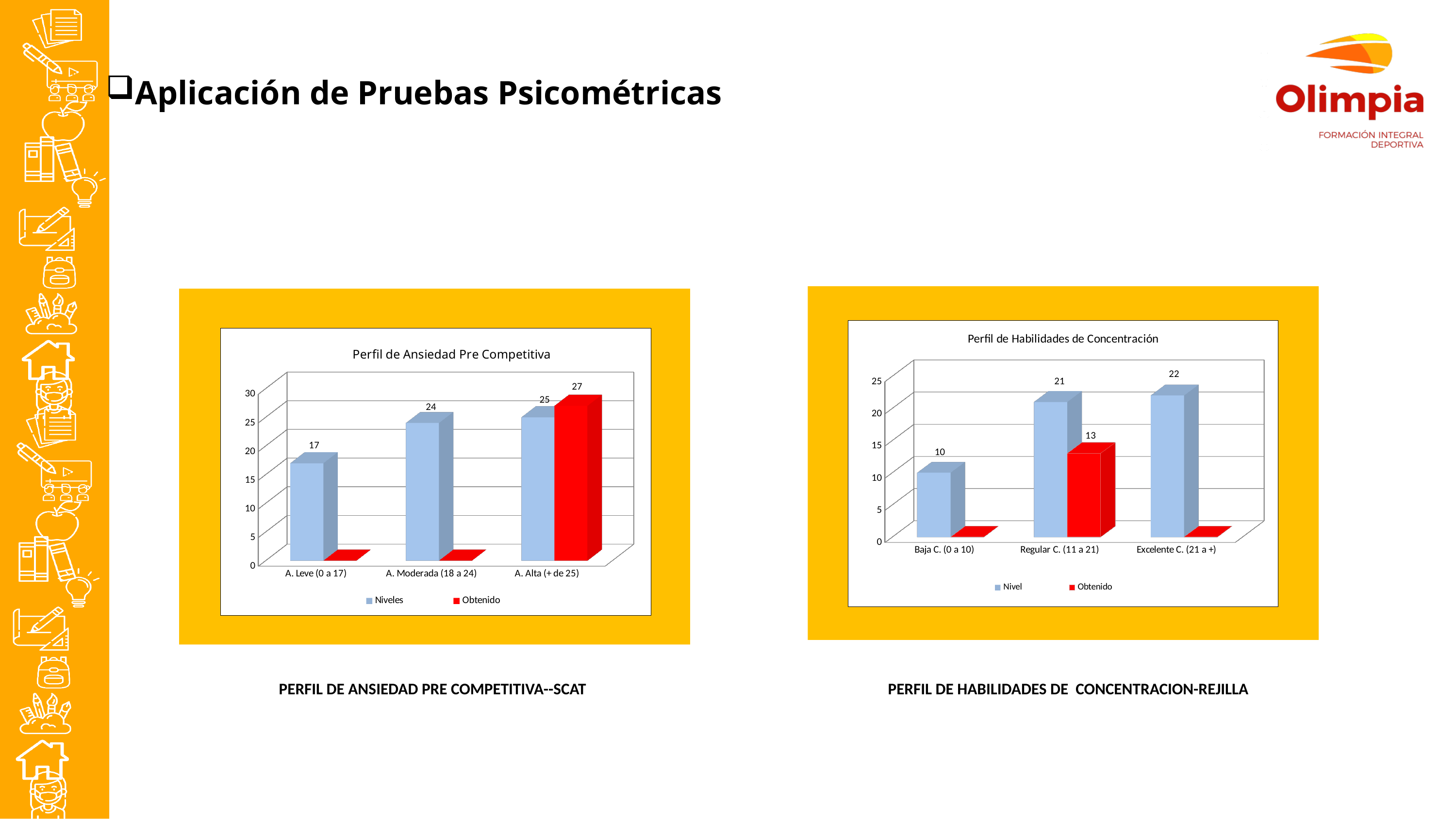
In the 'Perfil de Ansiedad Pre Competitiva' chart, what is the Obtenido value for A. Alta (+ de 25)? 27 What type of chart is the 'Perfil de Habilidades de Concentración' chart? bar chart In the 'Perfil de Ansiedad Pre Competitiva' chart, how many series does the legend list? 2 In the 'Perfil de Habilidades de Concentración' chart, what is the Obtenido value for Regular C. (11 a 21)? 13 In the 'Perfil de Ansiedad Pre Competitiva' chart, which category has the lowest Niveles value? A. Leve (0 a 17) In the 'Perfil de Habilidades de Concentración' chart, which category has the highest Nivel value? Excelente C. (21 a +) In the 'Perfil de Ansiedad Pre Competitiva' chart, do the Niveles values rise or fall from left to right? rise In the 'Perfil de Habilidades de Concentración' chart, which is larger for Regular C. (11 a 21): the Nivel value or the Obtenido value? Nivel In the 'Perfil de Ansiedad Pre Competitiva' chart, what is the difference between the Obtenido value and the Niveles value for A. Alta (+ de 25)? 2 In the 'Perfil de Ansiedad Pre Competitiva' chart, what is the Niveles value for A. Moderada (18 a 24)? 24 In the 'Perfil de Habilidades de Concentración' chart, how many categories are shown on the x axis? 3 In the 'Perfil de Habilidades de Concentración' chart, what is the Nivel value for Excelente C. (21 a +)? 22